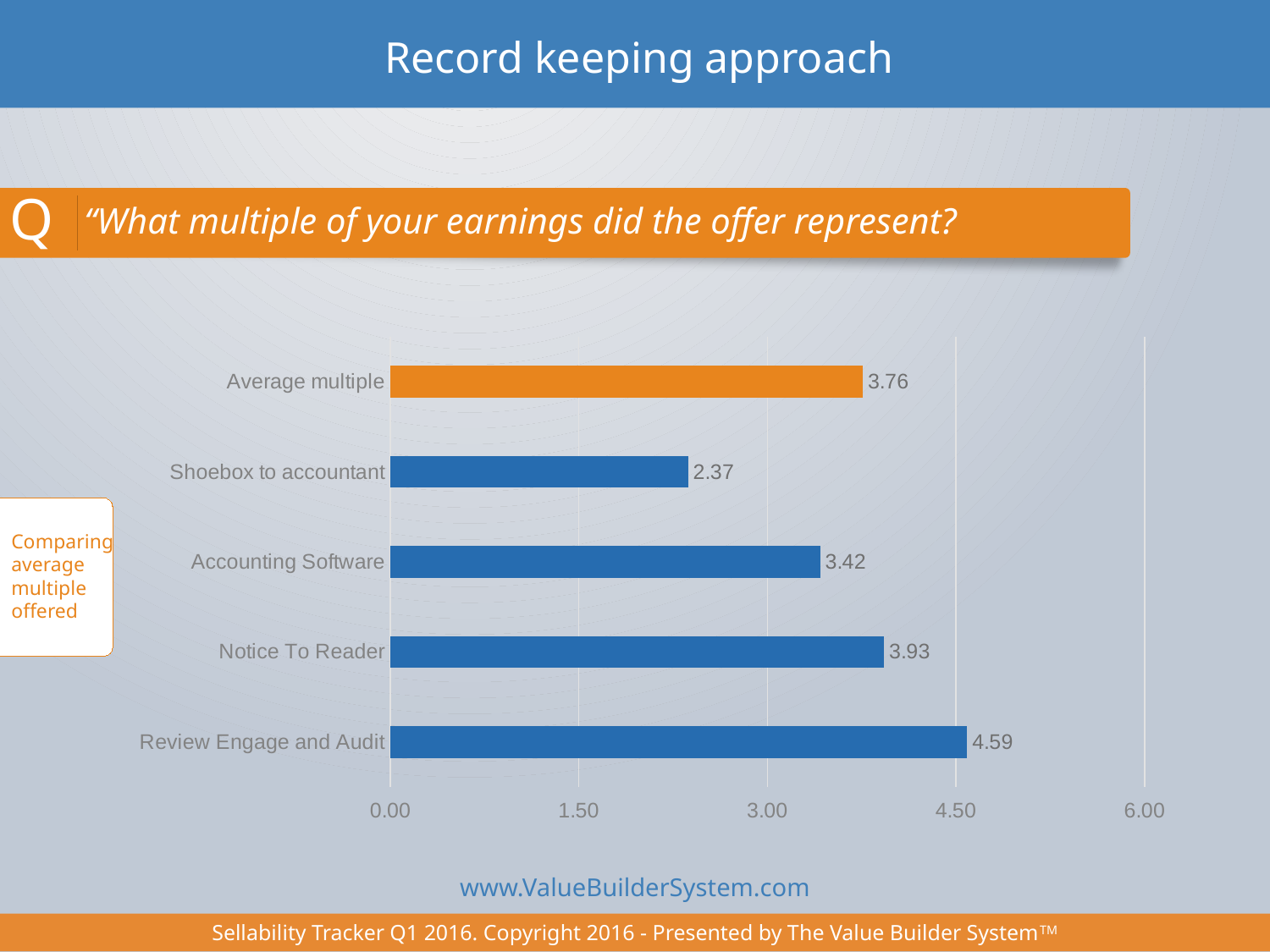
Which category has the highest value? Review Engage and Audit What is the value for Average multiple? 3.76 What is the value for Review Engage and Audit? 4.59 What is the value for Shoebox to accountant? 2.37 How many bars are shown in the chart? 5 What kind of chart is shown on the slide? bar chart Which category has the lowest value? Shoebox to accountant Which is larger, Notice To Reader or Accounting Software? Notice To Reader Which bar is coloured orange rather than blue? Average multiple What is the value for Accounting Software? 3.42 What is the difference between Review Engage and Audit and Shoebox to accountant? 2.22 Is the value for Notice To Reader greater or less than 4.50? less